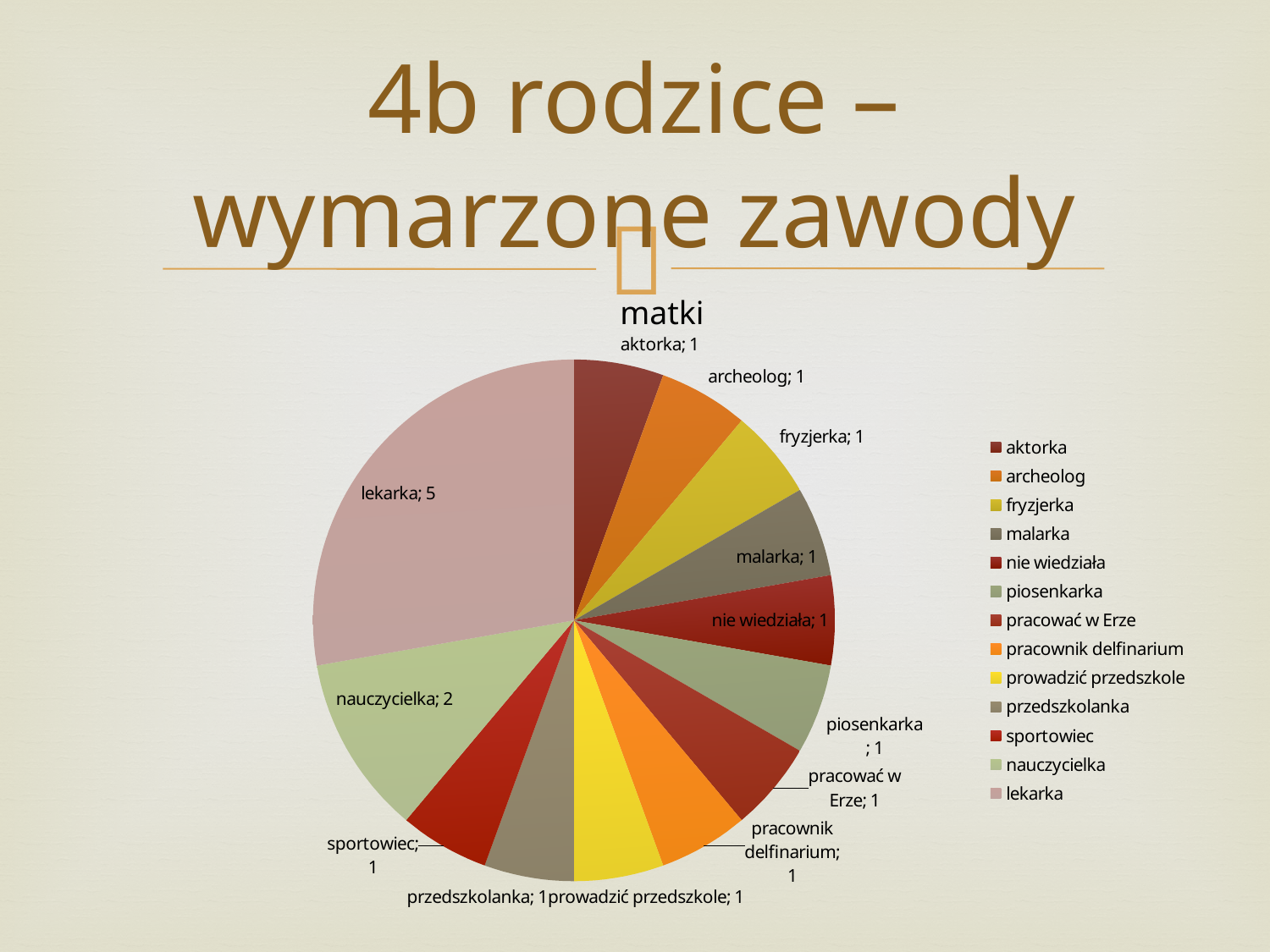
What is the title of the chart? matki Which is larger, the value for nauczycielka or the value for malarka? nauczycielka Which legend entry is listed last? lekarka Which category has the largest slice of the pie? lekarka What is the value for nauczycielka? 2 What is the value for pracownik delfinarium? 1 How many categories does the pie chart have? 13 How many categories have a value of 1? 11 What is the value for sportowiec? 1 What is the difference between the values for lekarka and nauczycielka? 3 What kind of chart is shown on the slide? pie chart What is the value for lekarka? 5